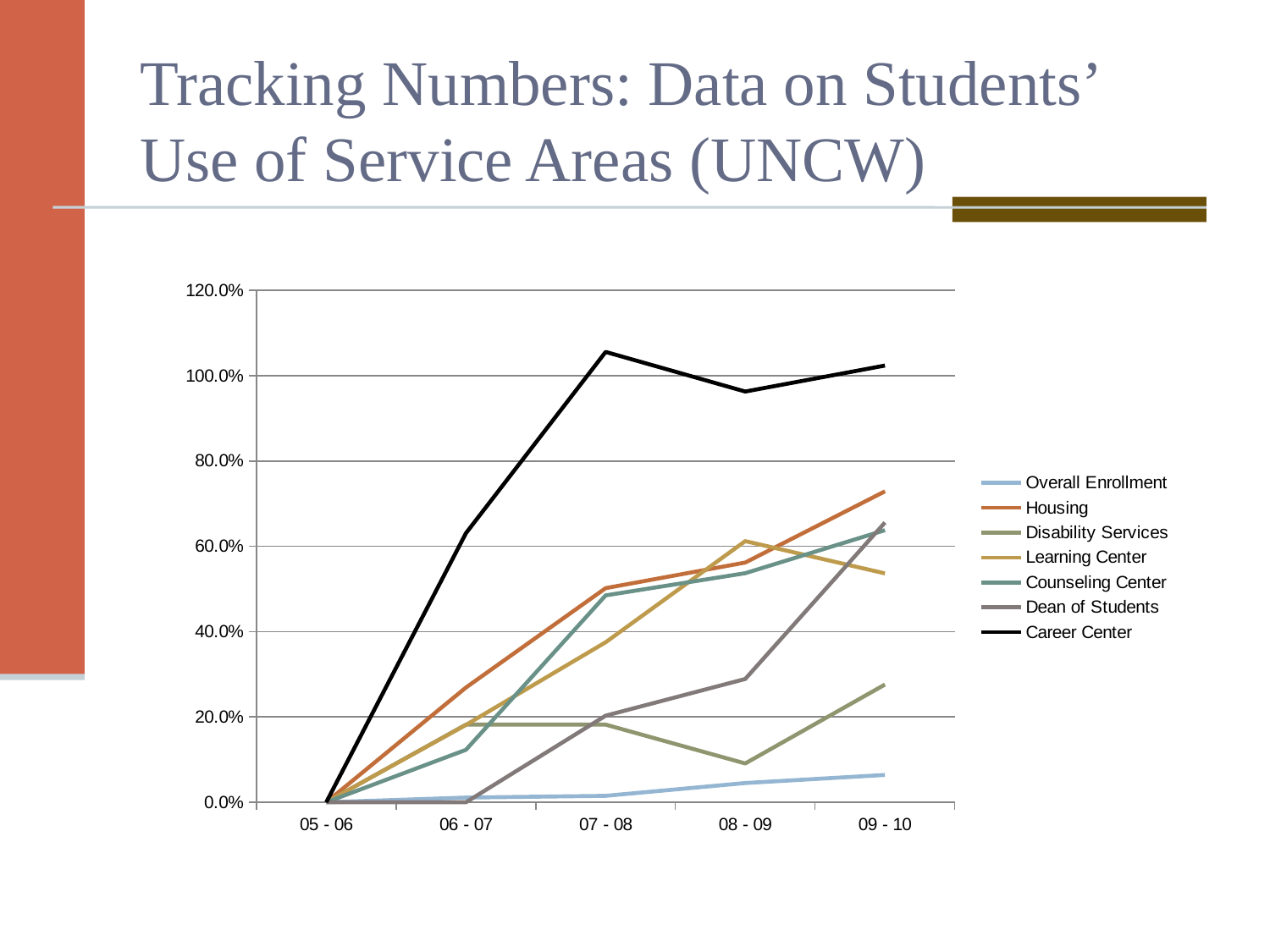
Which series is drawn with a black line? Career Center Which series has the lowest value in 09 - 10? Overall Enrollment How many academic-year categories are shown on the x axis? 5 How many series does the legend list? 7 Is the value for Housing in 09 - 10 greater or less than 60.0%? greater Which series has the highest value in 09 - 10? Career Center Is the value for Career Center in 07 - 08 greater or less than 100.0%? greater Which is larger in 06 - 07, Career Center or Housing? Career Center Does the Career Center line rise or fall from 05 - 06 to 07 - 08? rise What is the value for Career Center in 05 - 06? 0.0% Is the value for Disability Services in 08 - 09 greater or less than 20.0%? less What type of chart is shown on the slide? line chart